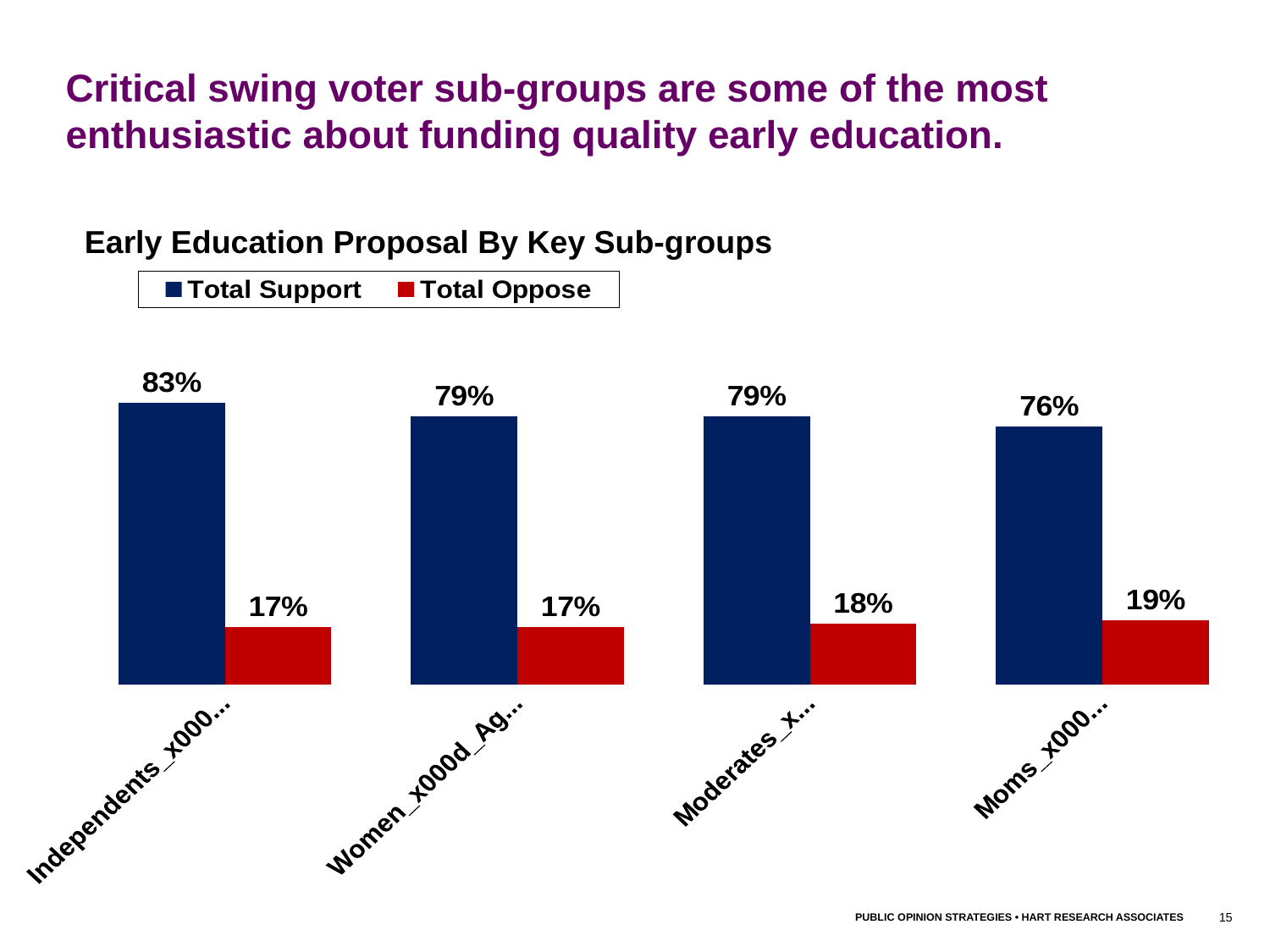
What is the difference between Total Support for Independents and Total Support for Moms? 7% What is the Total Oppose value for Women? 17% What is the Total Oppose value for Moms? 19% Which is larger: Total Oppose for Moderates or Total Oppose for Moms? Moms What is the Total Support value for Independents? 83% Which sub-group has the lowest Total Support value? Moms How many series does the legend list? 2 Which sub-group has the highest Total Support value? Independents How many sub-groups are shown on the chart? 4 Which sub-group has the highest Total Oppose value? Moms What is the Total Support value for Moderates? 79% What type of chart is shown on the slide? Bar chart